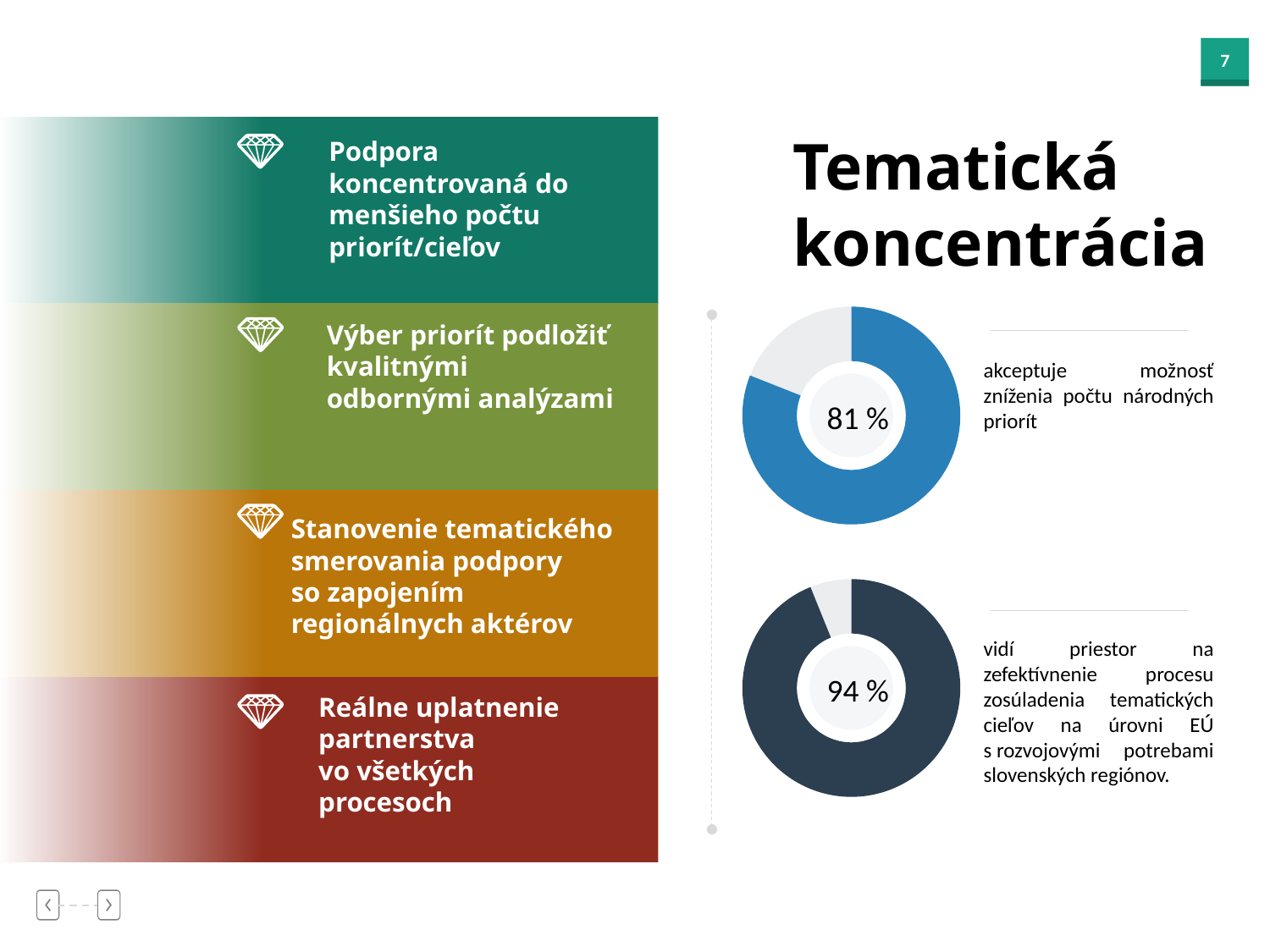
How many donut charts are on the slide? 2 Is the value in the upper donut chart greater or less than 50 %? greater What colour is the filled portion of the upper donut chart? Blue What is the difference between the percentage in the lower donut chart and the percentage in the upper donut chart? 13 % What percentage of respondents accept the possibility of reducing the number of national priorities, according to the upper donut chart? 81 % What kind of chart is used on the right side of the slide? Donut (pie) chart What value is shown in the centre of the upper donut chart? 81 % What value is shown in the centre of the lower donut chart? 94 % Is the value in the lower donut chart greater or less than 90 %? greater Which donut chart shows the larger percentage, the upper one or the lower one? The lower one How many slices does each donut chart have? 2 What is the title of the slide containing the donut charts? Tematická koncentrácia